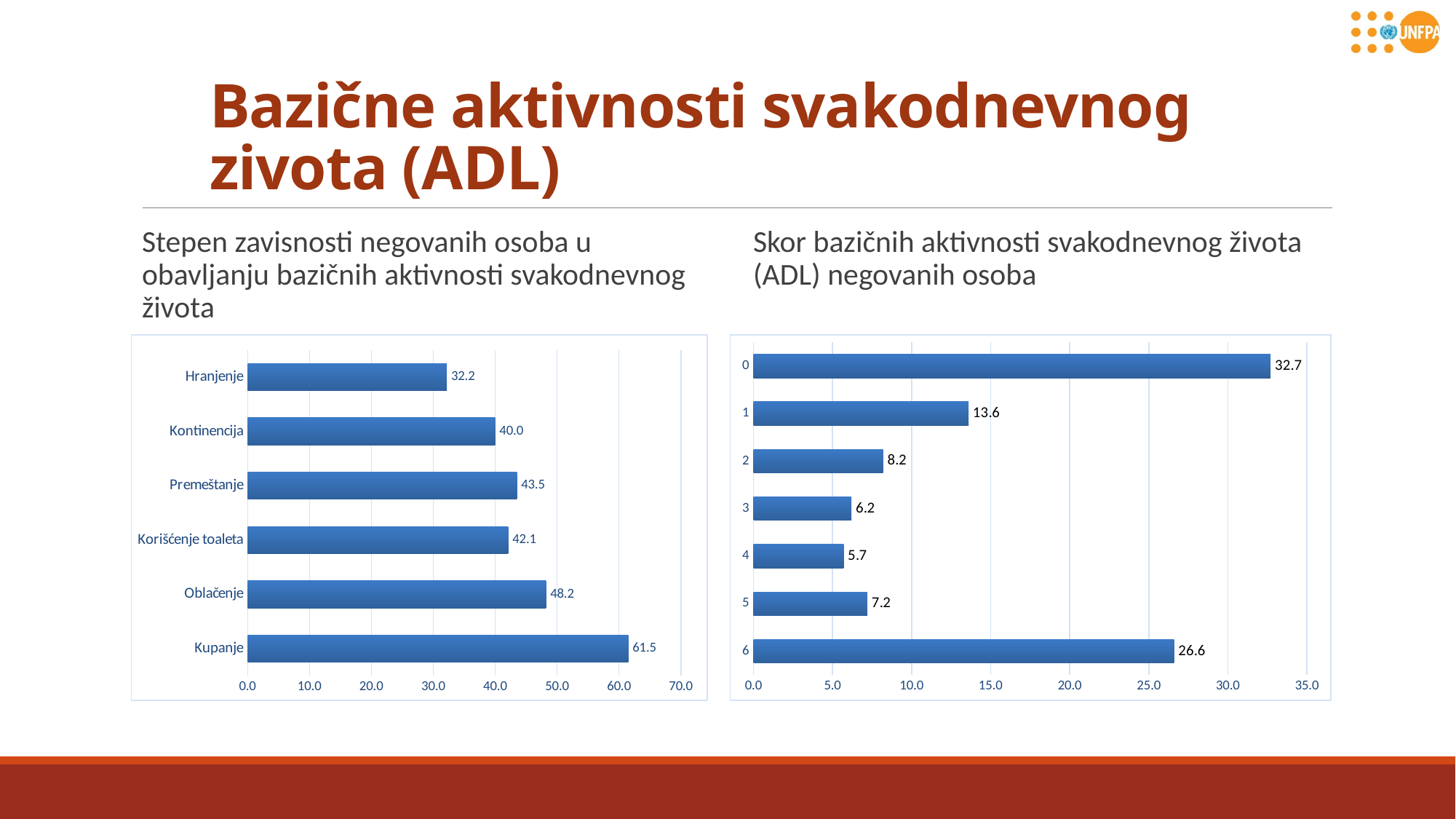
In the right chart (Skor bazičnih aktivnosti svakodnevnog života), what is the difference between the values for category 1 and category 2? 5.4 What type of chart is the right chart (Skor bazičnih aktivnosti svakodnevnog života)? Bar chart How many categories are shown in the left chart (Stepen zavisnosti negovanih osoba)? 6 In the right chart (Skor bazičnih aktivnosti svakodnevnog života), which category has the lowest value? 4 In the left chart (Stepen zavisnosti negovanih osoba), what is the value for Kupanje? 61.5 In the right chart (Skor bazičnih aktivnosti svakodnevnog života), what is the value for category 0? 32.7 In the left chart (Stepen zavisnosti negovanih osoba), which category has the lowest value? Hranjenje In the left chart (Stepen zavisnosti negovanih osoba), which is larger: Oblačenje or Premeštanje? Oblačenje In the left chart (Stepen zavisnosti negovanih osoba), which category has the highest value? Kupanje In the right chart (Skor bazičnih aktivnosti svakodnevnog života), what is the value for category 6? 26.6 In the left chart (Stepen zavisnosti negovanih osoba), what is the value for Kontinencija? 40.0 In the left chart (Stepen zavisnosti negovanih osoba), what is the difference between the values for Kupanje and Hranjenje? 29.3